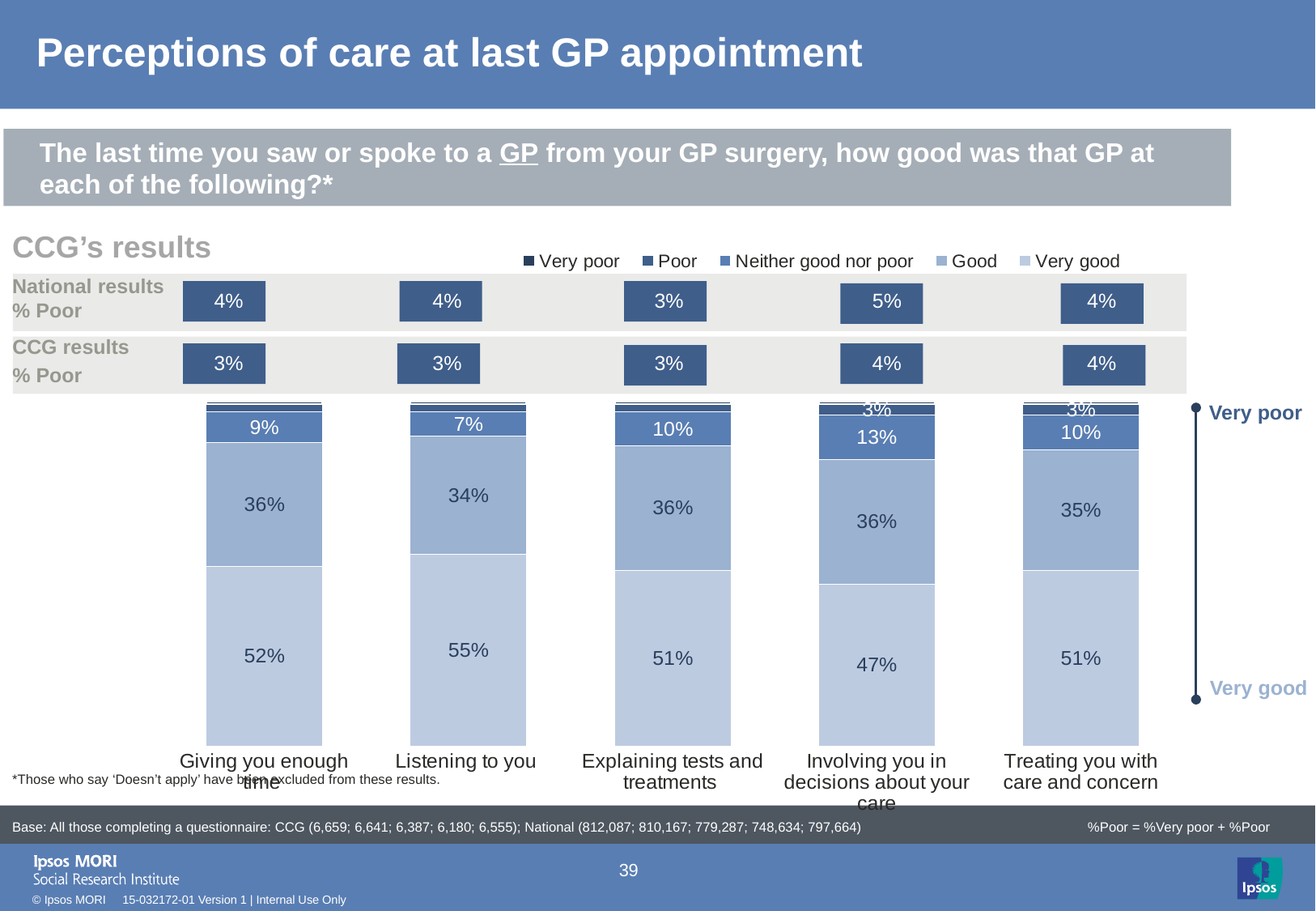
What kind of chart is used to show the CCG's results? Stacked bar chart In the 'National results % Poor' row, what is the value for 'Involving you in decisions about your care'? 5% What percentage of respondents rated the GP as 'Very good' at 'Listening to you'? 55% Which category has the lowest 'Very good' percentage? Involving you in decisions about your care Which is larger: the 'Neither good nor poor' percentage for 'Involving you in decisions about your care' or for 'Listening to you'? Involving you in decisions about your care Which category has the highest 'Very good' percentage? Listening to you What is the difference between the 'Very good' percentages for 'Listening to you' and 'Involving you in decisions about your care'? 8 percentage points How many categories are shown on the x axis of the stacked bar chart? 5 In the 'CCG results % Poor' row, what is the value for 'Giving you enough time'? 3% What percentage of respondents rated the GP as 'Good' at 'Involving you in decisions about your care'? 36% What percentage of respondents rated the GP as 'Neither good nor poor' at 'Explaining tests and treatments'? 10% How many series does the legend list? 5